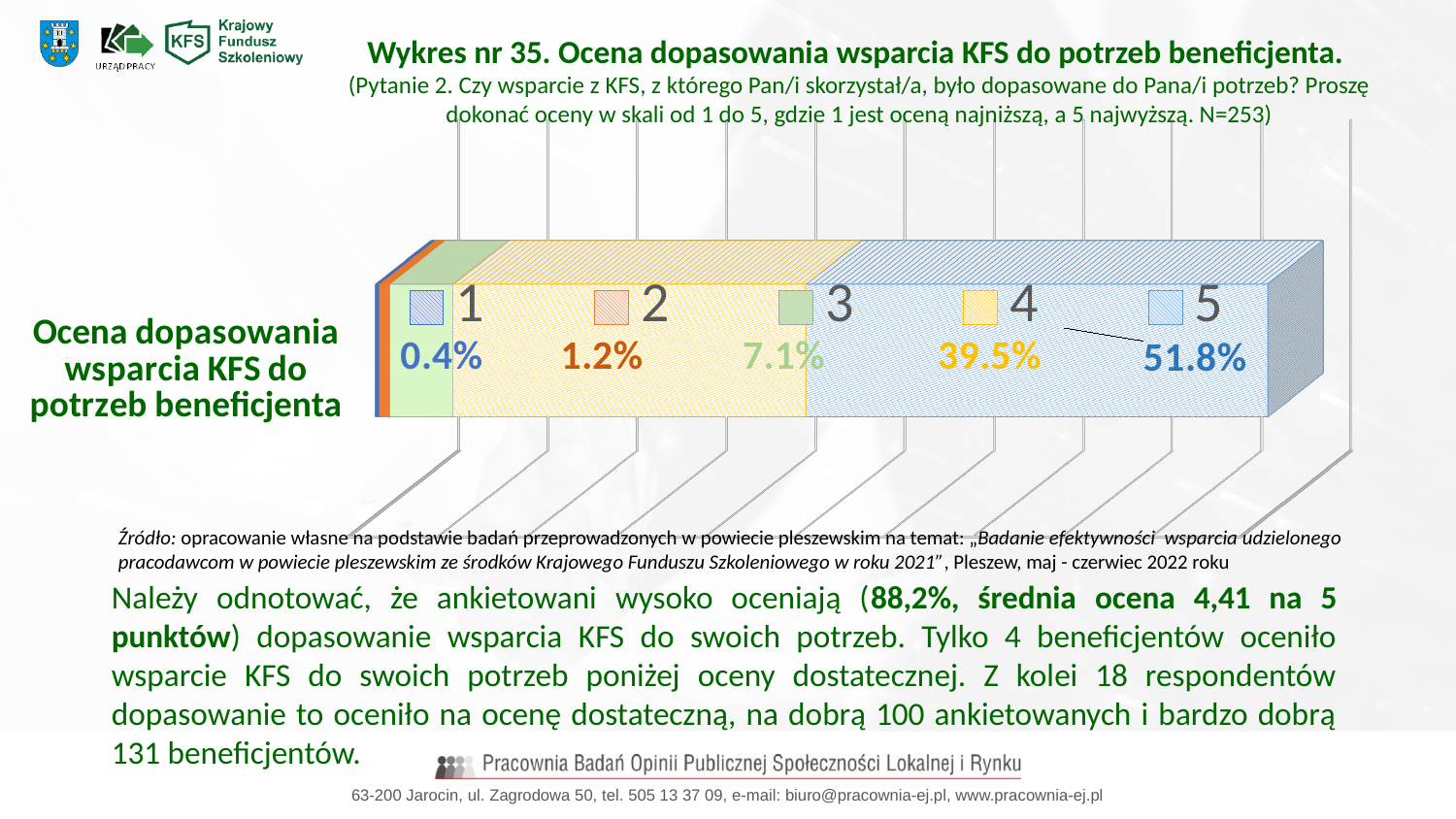
What share of respondents gave a rating of 5? 51.8% What is the difference in percentage points between the shares for rating 5 and rating 4? 12.3 Which has a larger share, rating 3 or rating 2? Rating 3 What is the combined share of ratings 4 and 5? 91.3% What share of respondents gave a rating of 3? 7.1% What share of respondents gave a rating of 4? 39.5% What share of respondents gave a rating of 1? 0.4% Which rating has the smallest share of respondents? 1 Which rating has the largest share of respondents? 5 What is the chart number given in the title? 35 What kind of chart is shown on the slide? Stacked bar chart How many rating categories are shown in the bar? 5